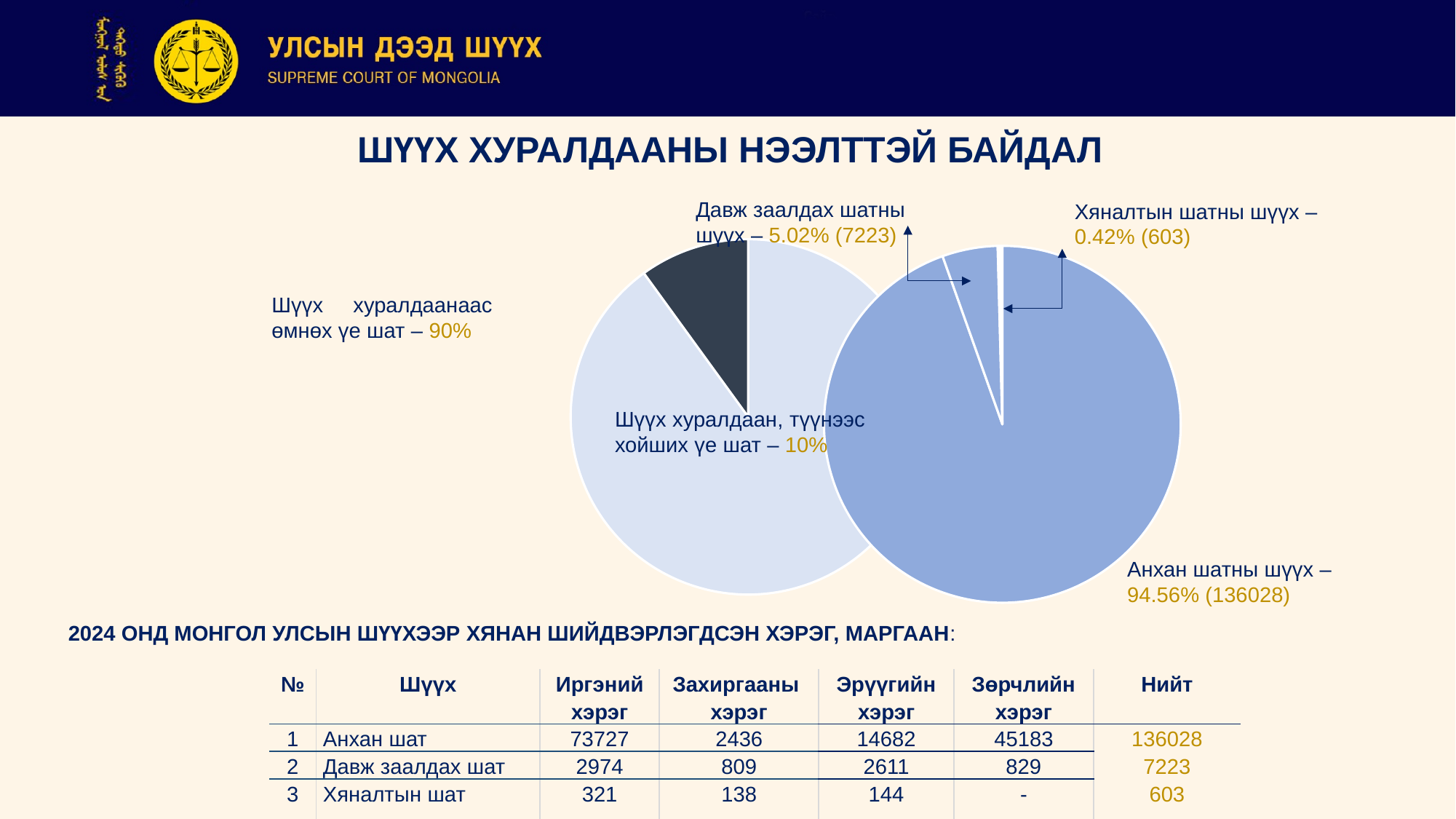
In the right pie chart, which slice is the smallest? Хяналтын шатны шүүх In the right pie chart, how many slices are there? 3 In the left pie chart, what share is labelled for 'Шүүх хуралдаан, түүнээс хойших үе шат'? 10% In the right pie chart, what is the difference between the counts for 'Давж заалдах шатны шүүх' and 'Хяналтын шатны шүүх'? 6620 In the left pie chart, which slice is the largest? Шүүх хуралдаанаас өмнөх үе шат In the left pie chart, how many slices are there? 2 In the left pie chart, what share is labelled for 'Шүүх хуралдаанаас өмнөх үе шат'? 90% What kind of charts are shown on the slide? Pie charts In the right pie chart, what percentage is labelled for 'Хяналтын шатны шүүх'? 0.42% In the right pie chart, what percentage is labelled for 'Анхан шатны шүүх'? 94.56% In the right pie chart, what count is shown in parentheses for 'Давж заалдах шатны шүүх'? 7223 In the right pie chart, which is larger: the share for 'Давж заалдах шатны шүүх' or 'Хяналтын шатны шүүх'? Давж заалдах шатны шүүх